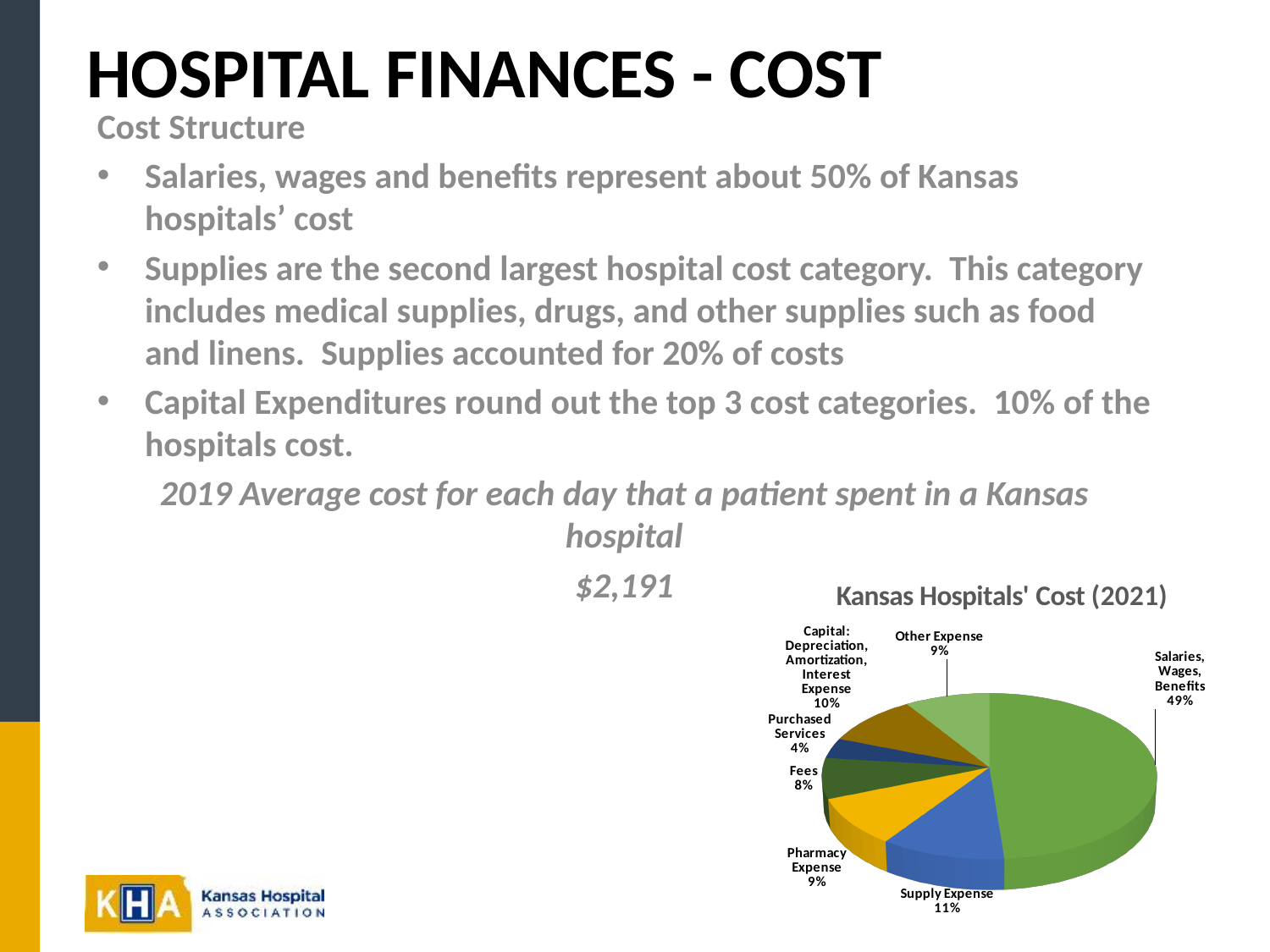
What percentage of cost is Supply Expense? 11% Which is larger, Fees or Other Expense? Other Expense What share of Kansas hospitals' cost is Salaries, Wages, Benefits? 49% What is the difference in percentage points between Supply Expense and Fees? 3 Which category has the largest share of the pie? Salaries, Wages, Benefits Which category has the smallest share of the pie? Purchased Services What percentage of cost is Pharmacy Expense? 9% What type of chart is shown on the slide? Pie chart How many slices does the pie chart have? 7 What percentage of cost is Purchased Services? 4% What percentage of cost is Capital: Depreciation, Amortization, Interest Expense? 10% What is the title of the chart? Kansas Hospitals' Cost (2021)